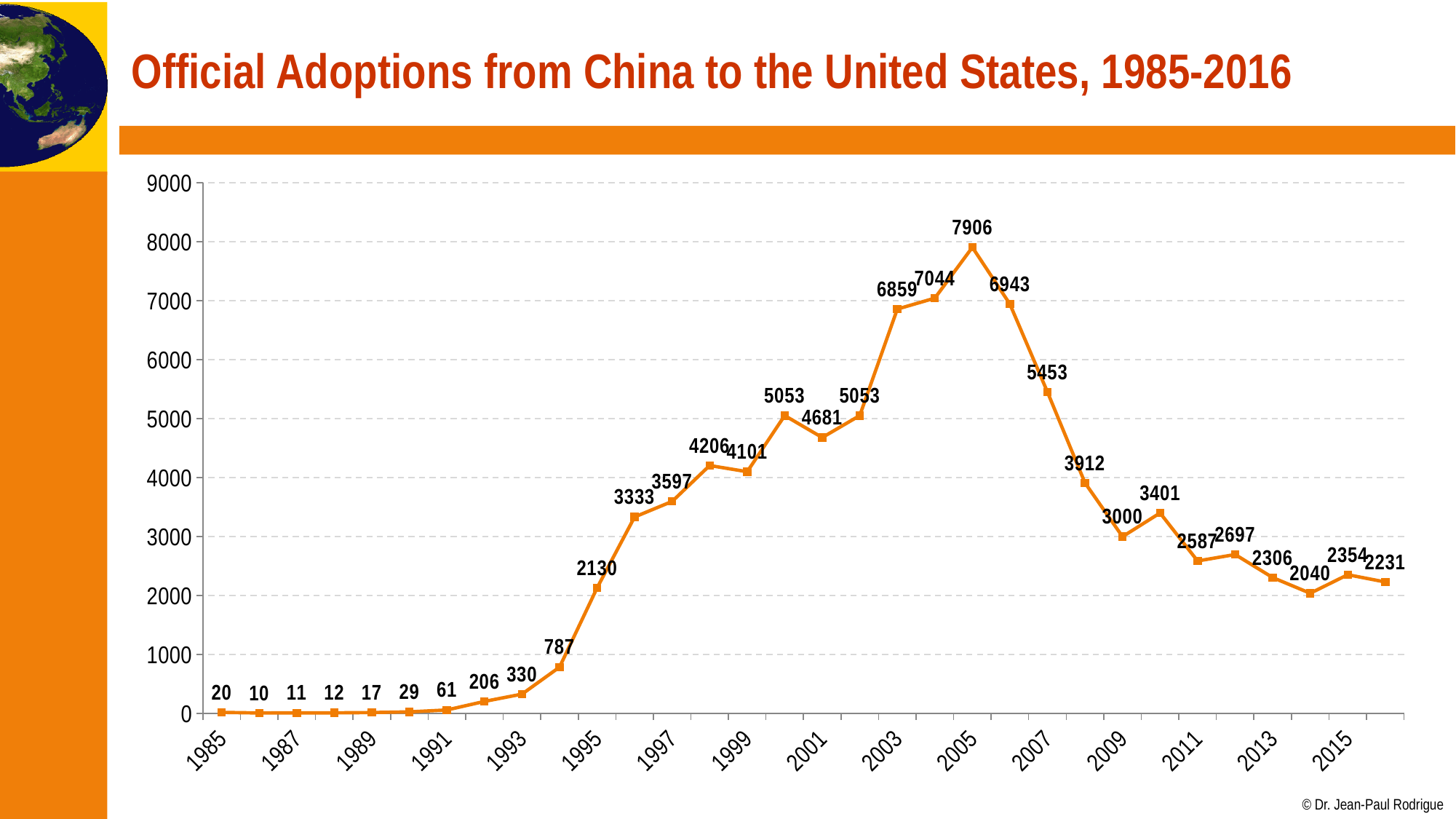
Is the value for 2003 greater or less than 6000? greater Do the values rise or fall from 2005 to 2016? fall How many adoptions from China to the United States were there in 2005? 7906 What is the value for 1995? 2130 What is the value for 1985? 20 Which is larger, the value for 1997 or the value for 2011? 1997 What is the value for 2009? 3000 Which year has the highest number of adoptions? 2005 How many data points are plotted on the chart? 32 What is the difference between the values for 2005 and 2007? 2453 Which year has the lowest number of adoptions? 1986 What type of chart is shown on the slide? line chart